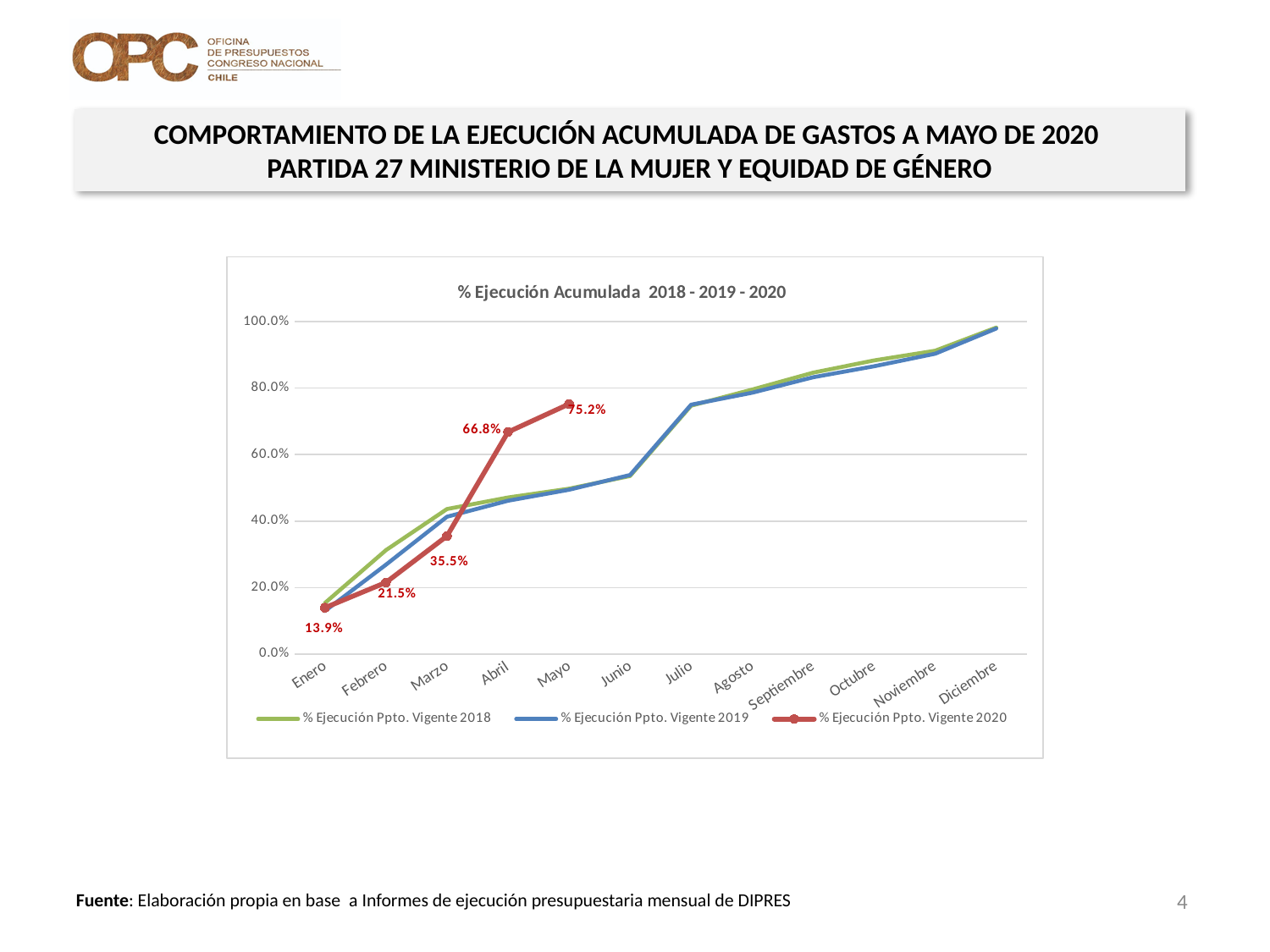
Which month has the lowest value for % Ejecución Ppto. Vigente 2020? Enero What is the difference between the 2020 values for Febrero and Enero? 7.6% What is the value of % Ejecución Ppto. Vigente 2020 for Abril? 66.8% What is the value of % Ejecución Ppto. Vigente 2020 for Mayo? 75.2% How many series does the legend list? 3 Is the value of % Ejecución Ppto. Vigente 2019 for Julio greater or less than 60.0%? greater What is the value of % Ejecución Ppto. Vigente 2020 for Enero? 13.9% What is the difference between the 2020 values for Mayo and Abril? 8.4% What type of chart is shown on the slide? Line chart What is the value of % Ejecución Ppto. Vigente 2020 for Marzo? 35.5% Which month has the highest value for % Ejecución Ppto. Vigente 2020? Mayo How many months are shown on the x axis? 12